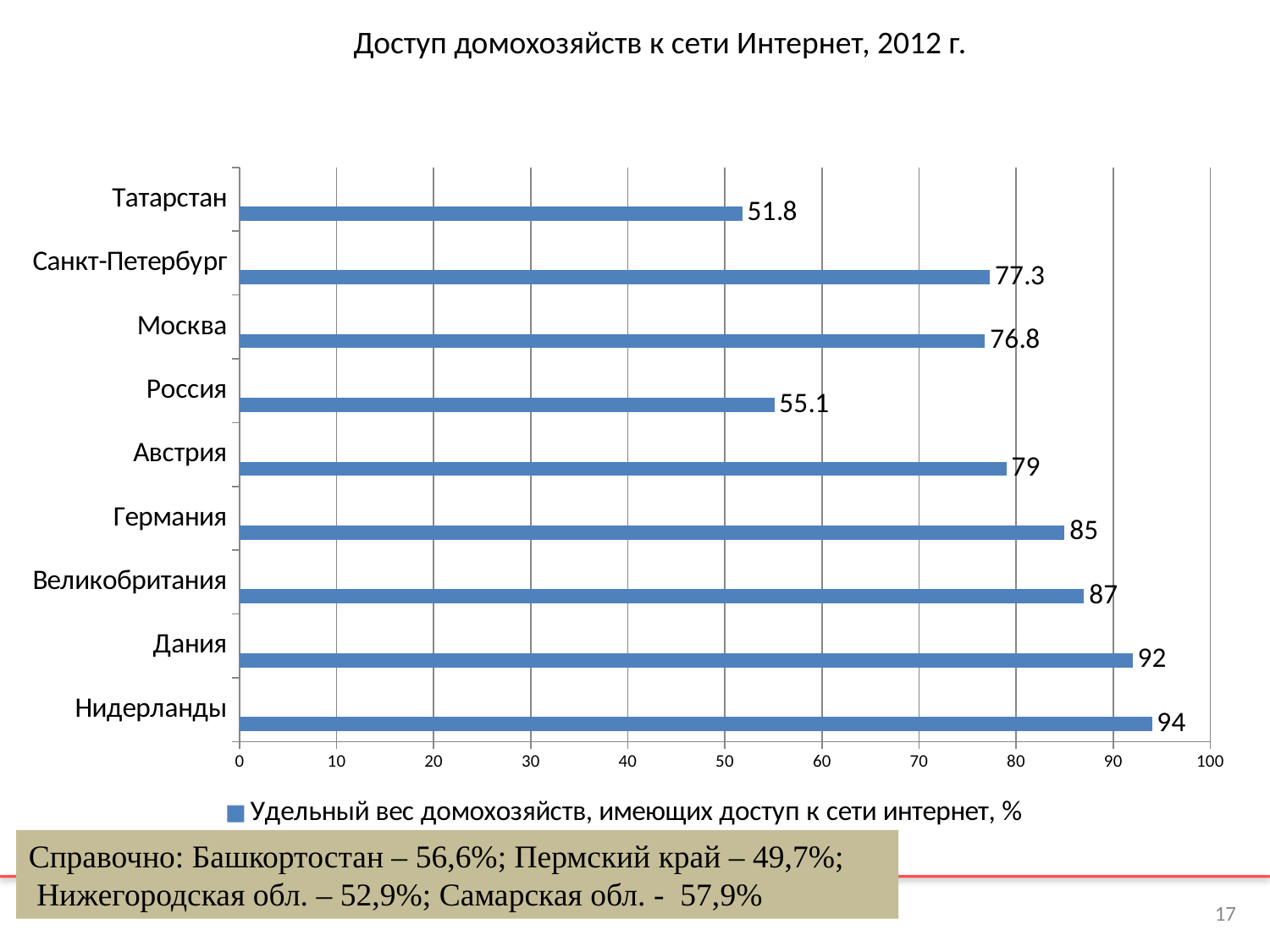
How many categories are shown in the chart? 9 What is the difference between the values for Санкт-Петербург and Москва? 0.5 What kind of chart is shown on the slide? bar chart Which is larger, the value for Австрия or the value for Россия? Австрия Which category has the lowest value? Татарстан What is the title of the chart? Доступ домохозяйств к сети Интернет, 2012 г. Is the value for Москва greater or less than 70? greater What is the difference between the values for Дания and Великобритания? 5 What is the value for Германия? 85 What is the value for Татарстан? 51.8 Which category has the highest value? Нидерланды What is the value for Россия? 55.1